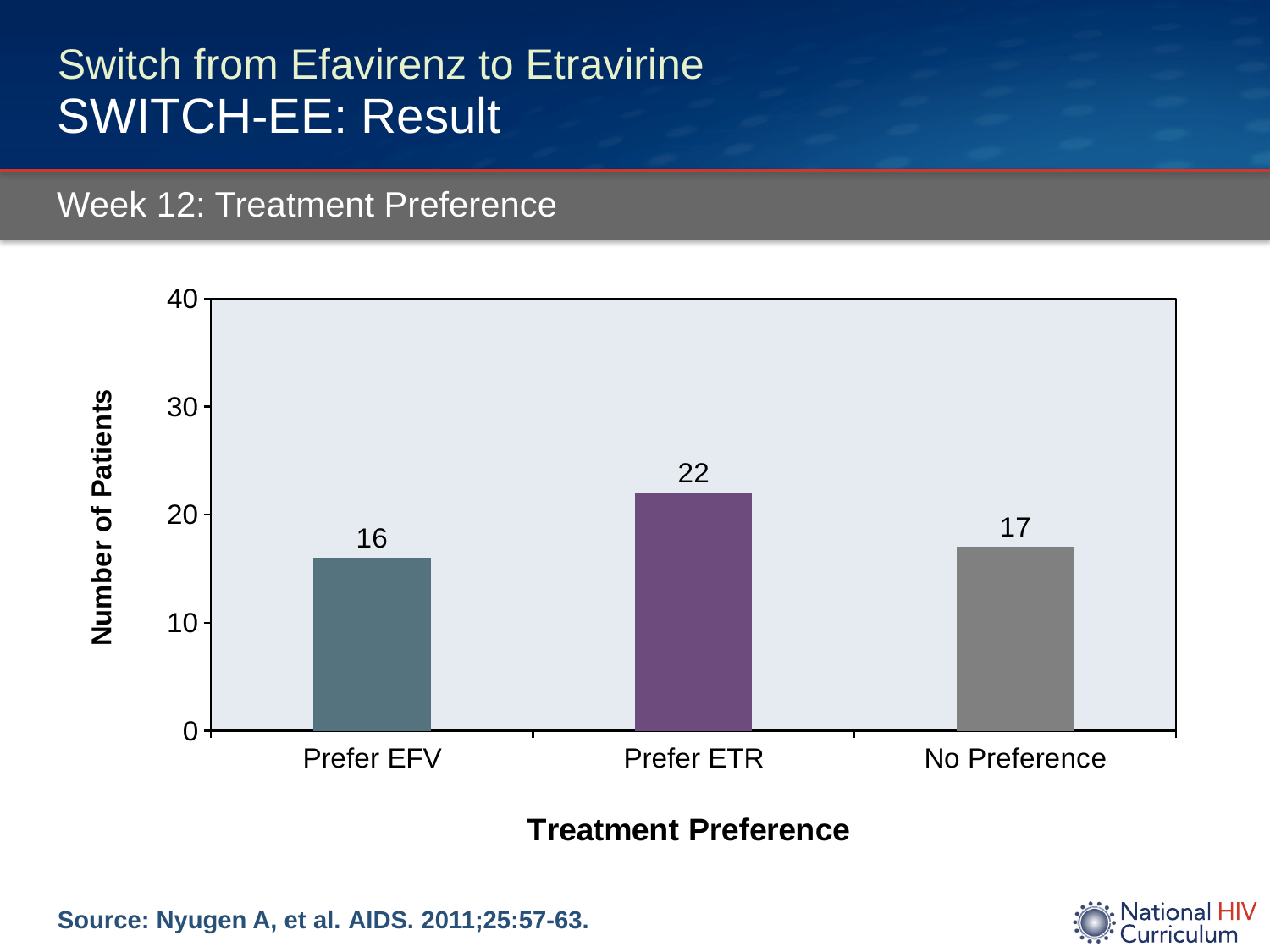
Which treatment preference category has the lowest number of patients? Prefer EFV How many treatment preference categories are shown on the x axis? 3 What is the difference in number of patients between No Preference and Prefer EFV? 1 What is the number of patients with No Preference? 17 Is the value for Prefer ETR greater or less than 20? greater What is the label of the y axis? Number of Patients What kind of chart is shown on the slide? Bar chart What is the difference in number of patients between Prefer ETR and Prefer EFV? 6 Which treatment preference category has the highest number of patients? Prefer ETR How many patients preferred ETR? 22 How many patients preferred EFV? 16 Which has more patients, Prefer ETR or No Preference? Prefer ETR